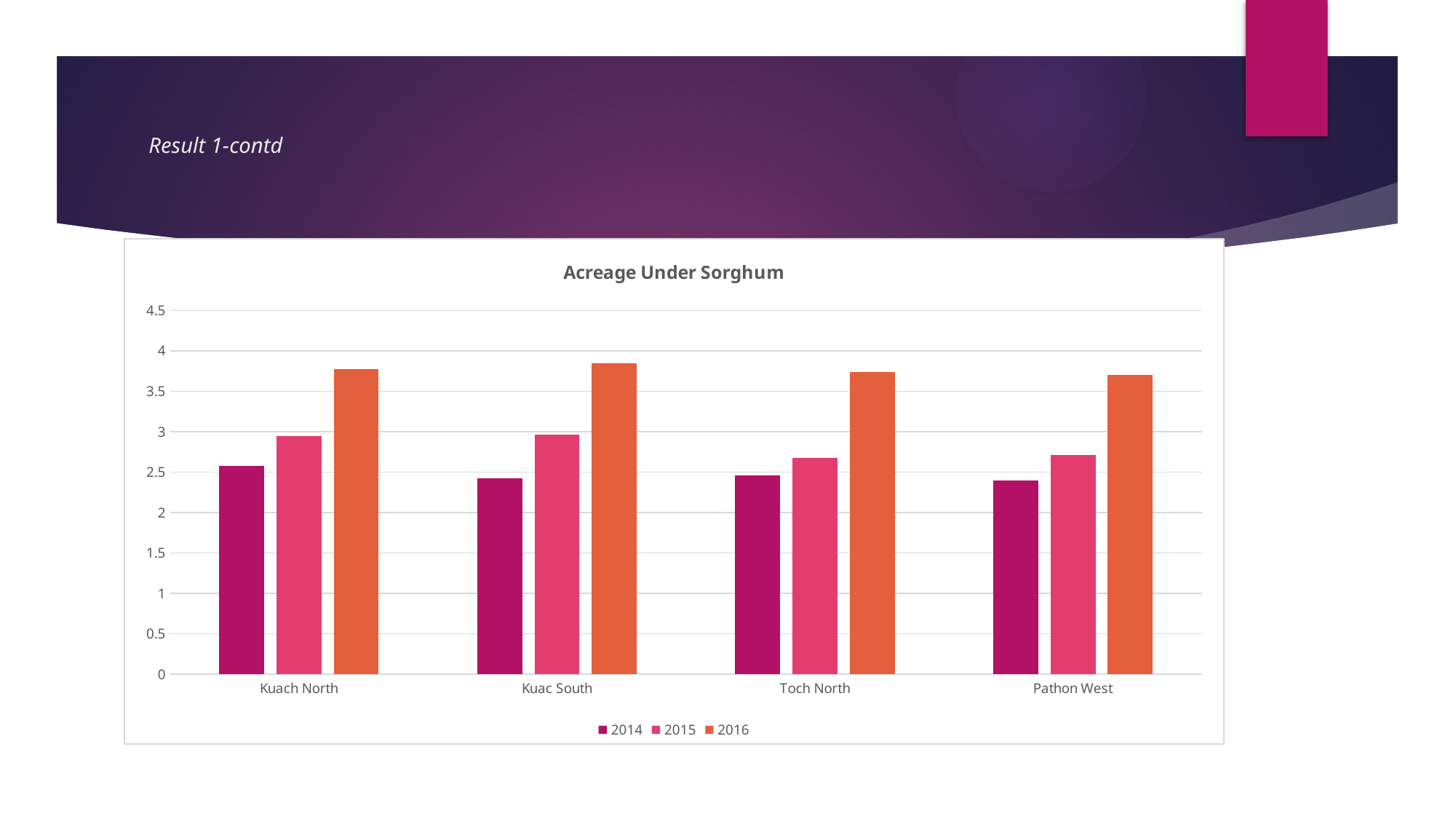
What is the title of the chart? Acreage Under Sorghum Which year has the highest value for Kuac South? 2016 Which category has the highest value for 2014? Kuach North Is the value for Kuach North in 2016 greater or less than 3.5? greater How many series does the legend list? 3 What kind of chart is shown on the slide? Bar chart For Pathon West, do the values rise or fall from 2014 to 2016? rise How many categories are shown on the x axis? 4 Which is larger, the 2015 value for Kuac South or the 2015 value for Toch North? Kuac South Is the value for Kuac South in 2014 greater or less than 2.5? less Is the value for Kuac South in 2016 greater or less than 4? less Which year has the lowest value for Toch North? 2014